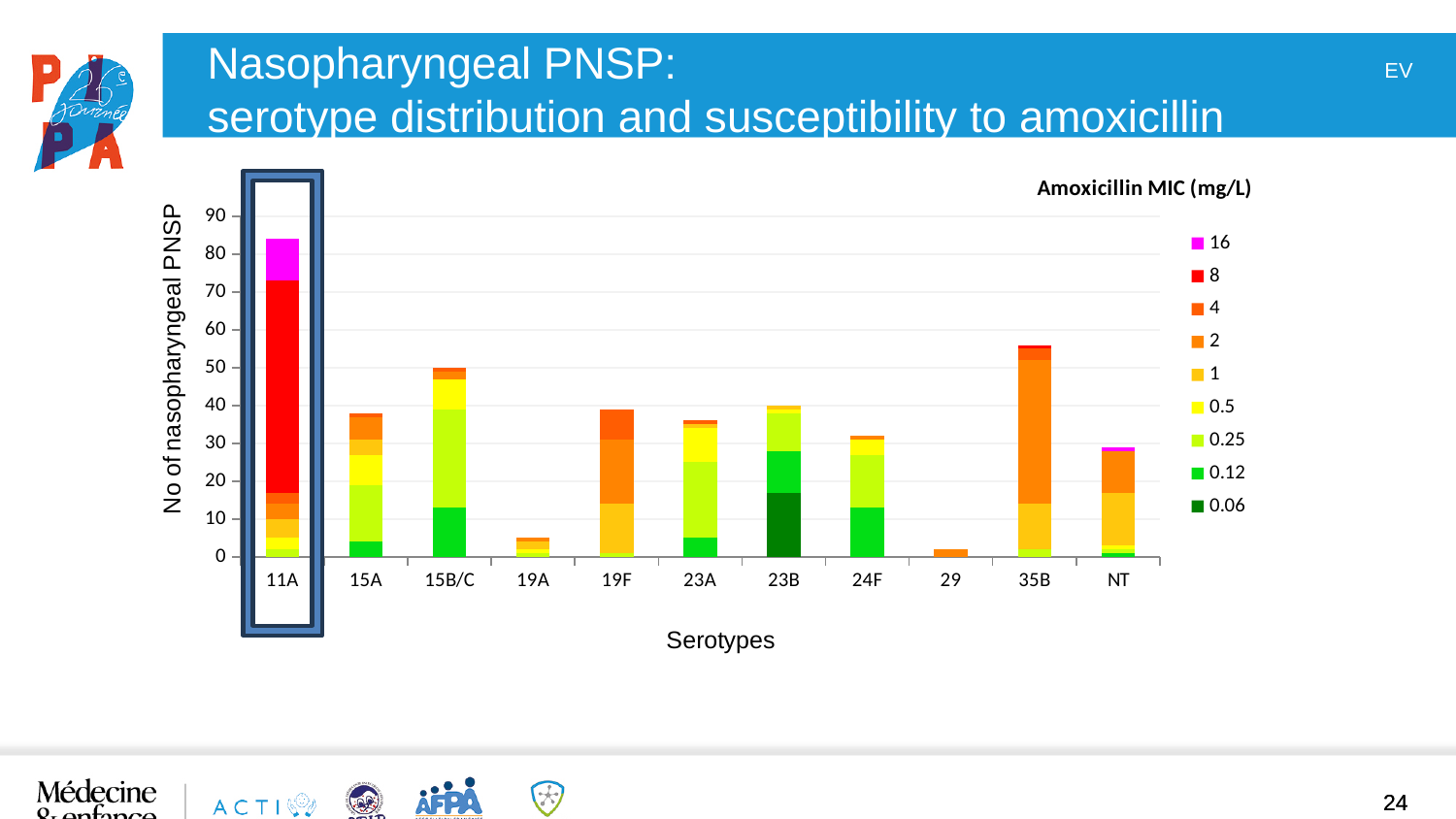
Which serotype has the highest total number of nasopharyngeal PNSP? 11A What kind of chart is shown on the slide? stacked bar chart How many serotype categories are shown on the x axis? 11 How many series does the legend list? 9 Is the total value for serotype 19A greater or less than 10? less Which serotype has a larger total, 11A or 35B? 11A Is the total value for serotype 11A greater or less than 80? greater What is the title of the legend? Amoxicillin MIC (mg/L) Which serotype has a larger total, 15B/C or 19A? 15B/C Is the total value for serotype 35B greater or less than 50? greater Which serotype has the lowest total number of nasopharyngeal PNSP? 29